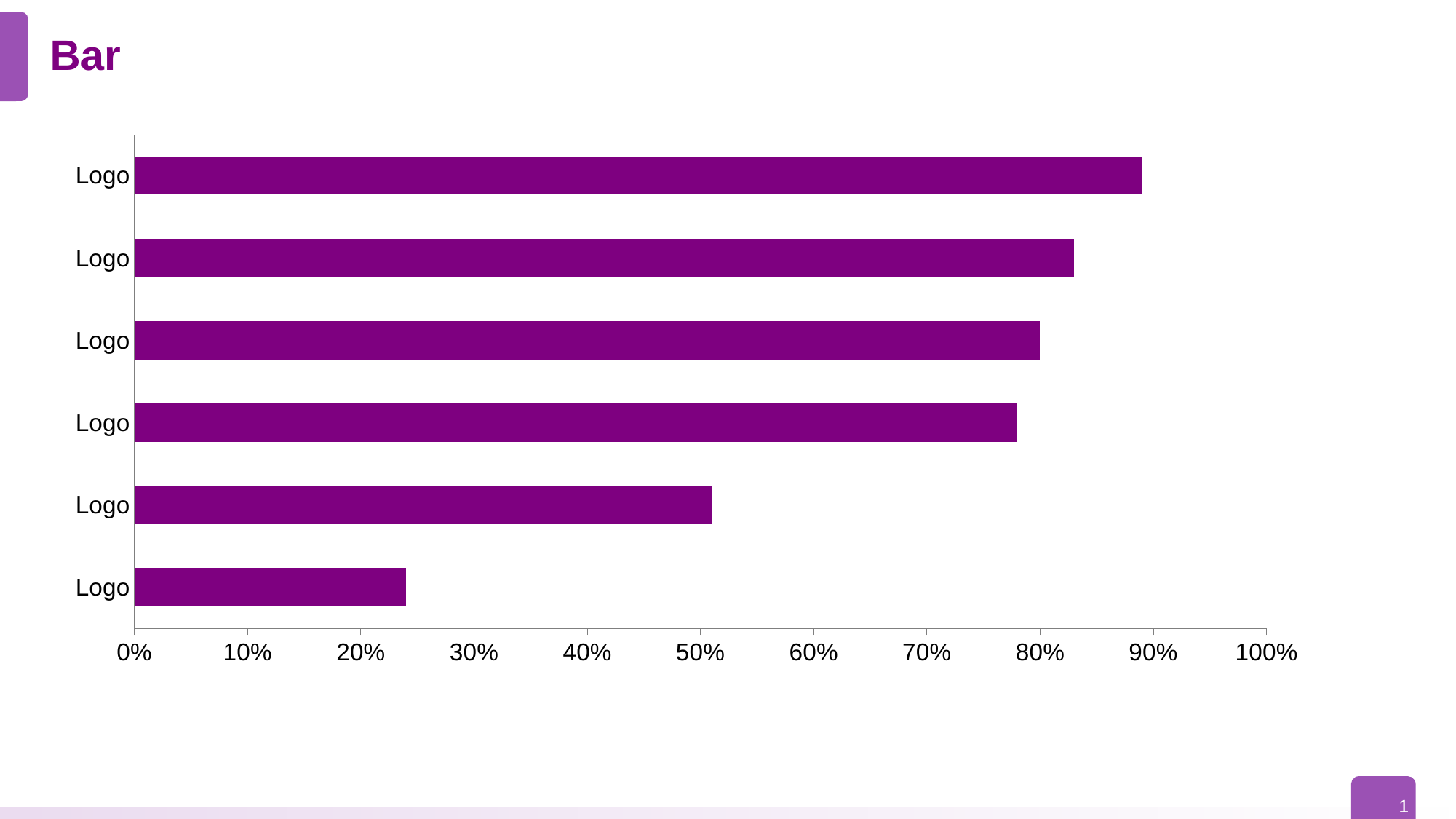
Do the bar values increase or decrease going from the top bar to the bottom bar? decrease Which bar is the longest: the top bar or the bottom bar? the top bar What is the title of the slide? Bar Is the value of the bottom bar greater or less than 30%? less How many bars does the chart show? 6 Is the value of the top bar greater or less than 80%? greater Which is larger: the value of the second bar from the top or the value of the fifth bar from the top? the second bar from the top Which bar has the lowest value? the bottom bar Is the value of the third bar from the top greater or less than 70%? greater What is the highest value shown on the horizontal axis? 100% What kind of chart is shown on the slide? bar chart